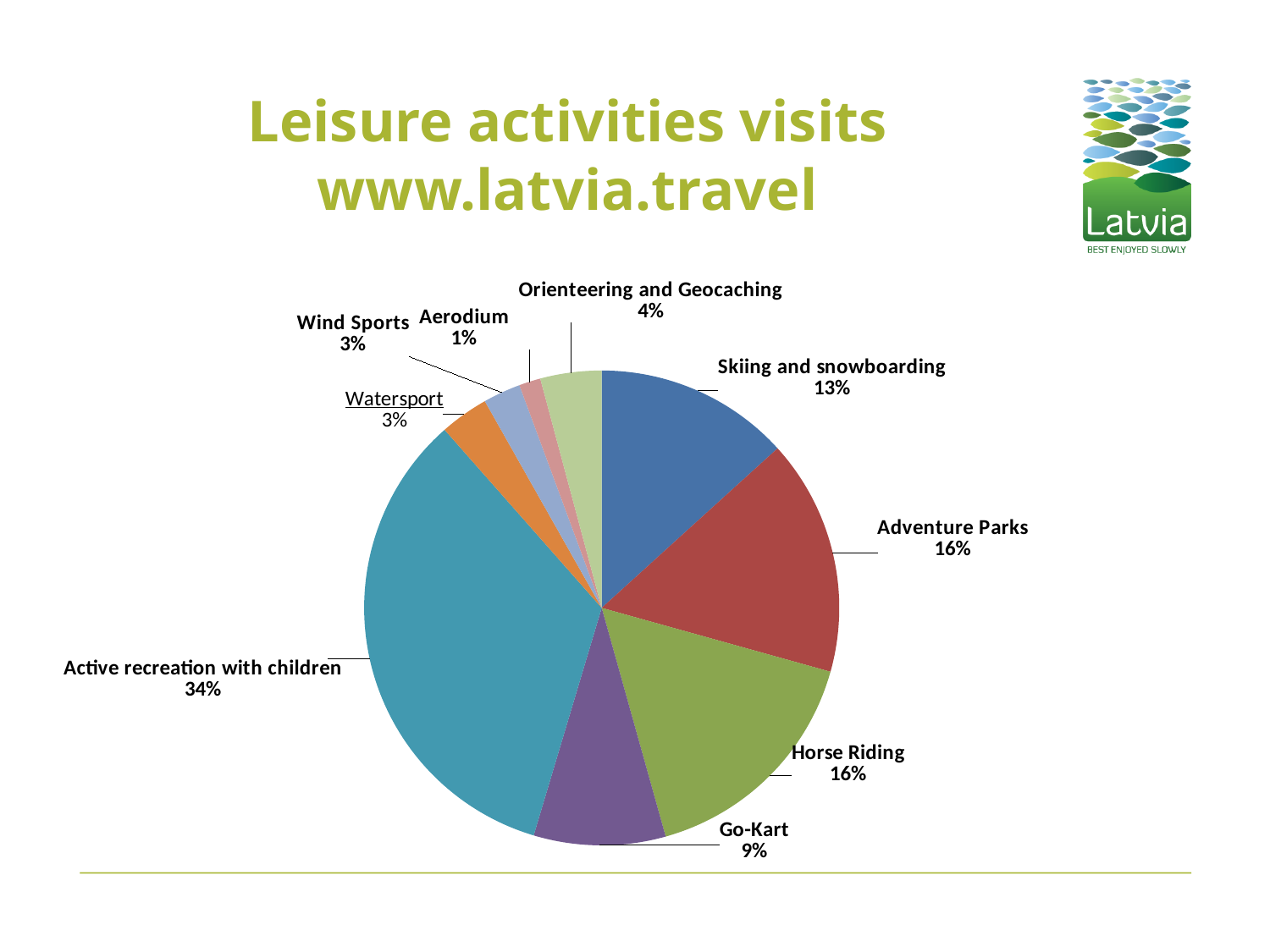
What kind of chart is shown on the slide? pie chart What share of leisure activity visits is Active recreation with children? 34% What is the title of the chart on the slide? Leisure activities visits www.latvia.travel What percentage is shown for Go-Kart? 9% Which category has the smallest slice of the pie? Aerodium What percentage is shown for Skiing and snowboarding? 13% How many categories are shown in the pie chart? 9 What is the difference in percentage points between Active recreation with children and Adventure Parks? 18 What percentage is shown for Aerodium? 1% What percentage is shown for Orienteering and Geocaching? 4% Which is larger, Skiing and snowboarding or Go-Kart? Skiing and snowboarding Which category has the largest slice of the pie? Active recreation with children